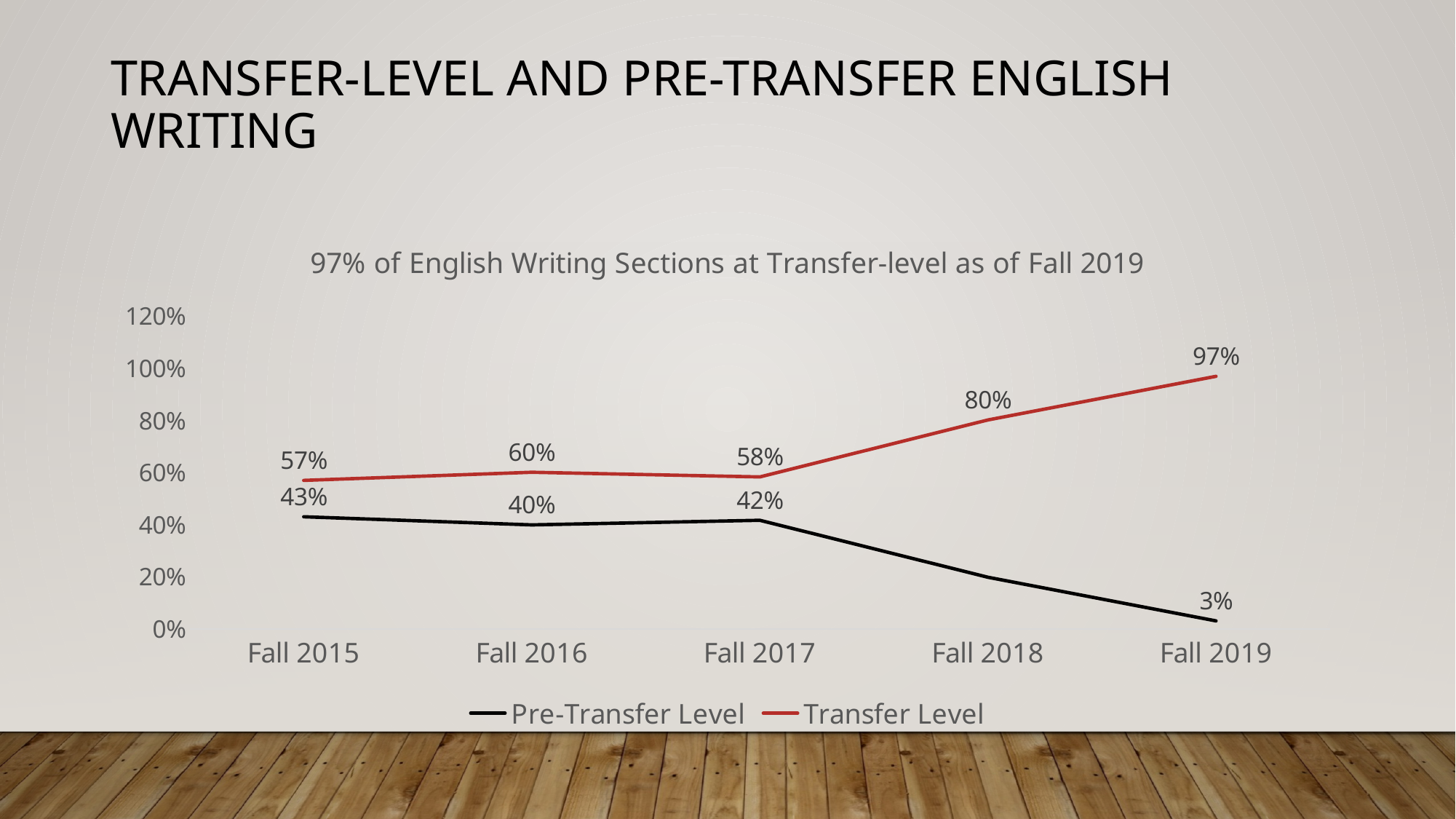
What is the Pre-Transfer Level value for Fall 2019? 3% How many series does the legend list? 2 In which term is the Transfer Level value highest? Fall 2019 Does the Transfer Level line rise or fall from Fall 2017 to Fall 2019? rise What is the Pre-Transfer Level value for Fall 2015? 43% What is the Transfer Level value for Fall 2019? 97% What is the Transfer Level value for Fall 2018? 80% What type of chart is shown on the slide? line chart Is the Pre-Transfer Level value for Fall 2018 greater or less than 40%? less In which term is the Pre-Transfer Level value lowest? Fall 2019 Which is larger in Fall 2016: the Transfer Level value or the Pre-Transfer Level value? Transfer Level What is the difference between the Transfer Level and Pre-Transfer Level values in Fall 2017? 16%